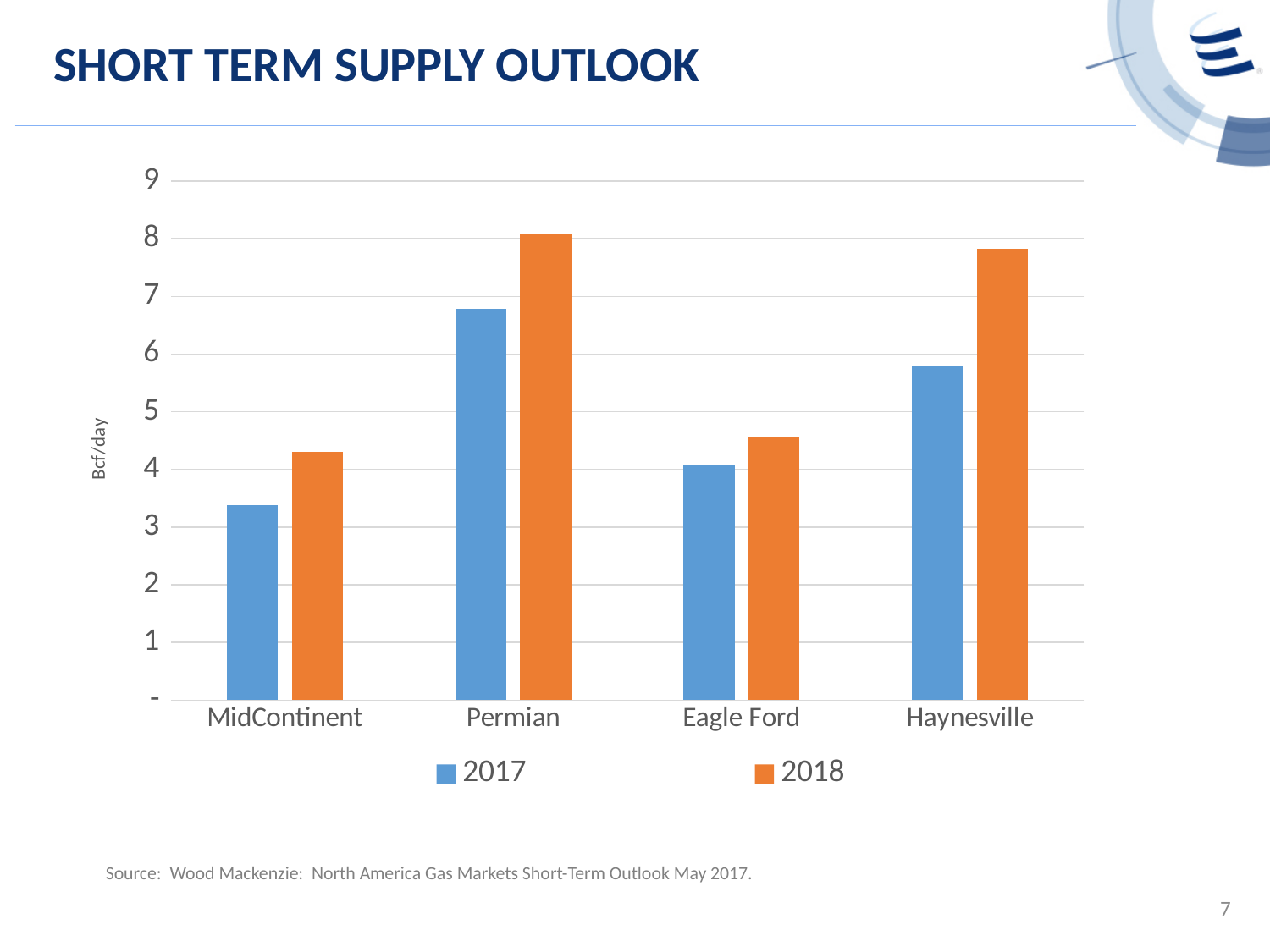
Is the 2017 value for MidContinent greater or less than 4? less Which region has the lowest 2018 value? MidContinent How many series does the chart's legend list? 2 What kind of chart is shown on the slide? bar chart Which region has the lowest 2017 value? MidContinent What unit is shown on the chart's y axis label? Bcf/day How many regions are shown along the x axis of the chart? 4 For Permian, which year has the larger value, 2017 or 2018? 2018 Is the 2017 value for Haynesville greater or less than 5? greater Which region has the highest 2018 value? Permian Which is larger: the 2018 value for Haynesville or the 2018 value for Eagle Ford? Haynesville